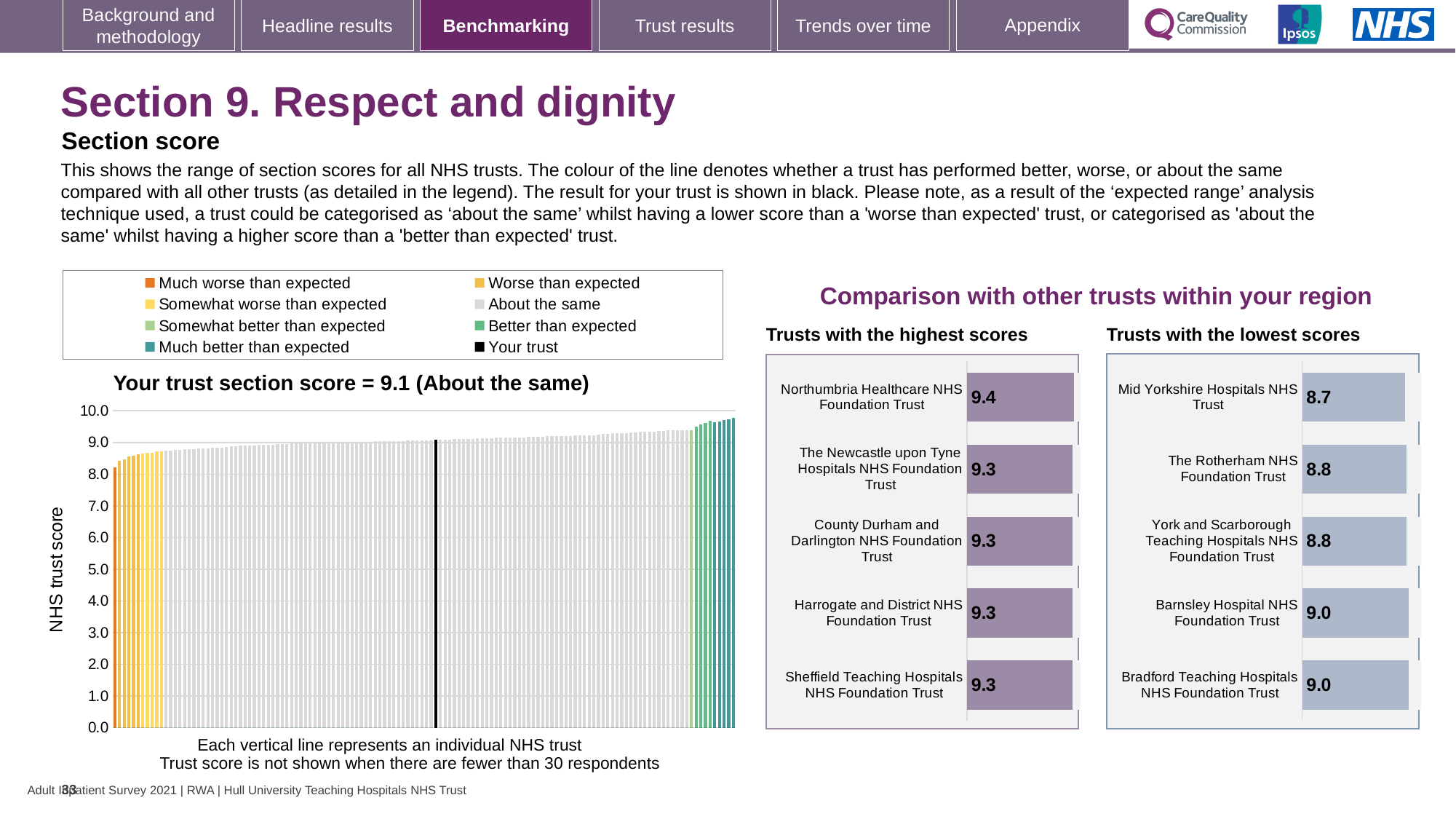
In the 'Trusts with the lowest scores' chart, what is the score for Mid Yorkshire Hospitals NHS Trust? 8.7 In the 'Trusts with the highest scores' chart, what is the score for Sheffield Teaching Hospitals NHS Foundation Trust? 9.3 In the 'Trusts with the highest scores' chart, which trust has the highest score? Northumbria Healthcare NHS Foundation Trust How many entries does the legend above the left chart list? 8 According to the left chart's title, what is your trust's section score? 9.1 What kind of chart is the 'Your trust section score' chart on the left? Bar chart In the 'Trusts with the lowest scores' chart, what is the difference between the scores of Barnsley Hospital NHS Foundation Trust and Mid Yorkshire Hospitals NHS Trust? 0.3 In the 'Trusts with the lowest scores' chart, which has the larger score: The Rotherham NHS Foundation Trust or Barnsley Hospital NHS Foundation Trust? Barnsley Hospital NHS Foundation Trust In the 'Trusts with the lowest scores' chart, which trust has the lowest score? Mid Yorkshire Hospitals NHS Trust In the left chart, is the value of the tallest bar greater or less than 9.0? greater How many trusts are listed in the 'Trusts with the highest scores' chart? 5 In the 'Trusts with the highest scores' chart, what is the score for Northumbria Healthcare NHS Foundation Trust? 9.4